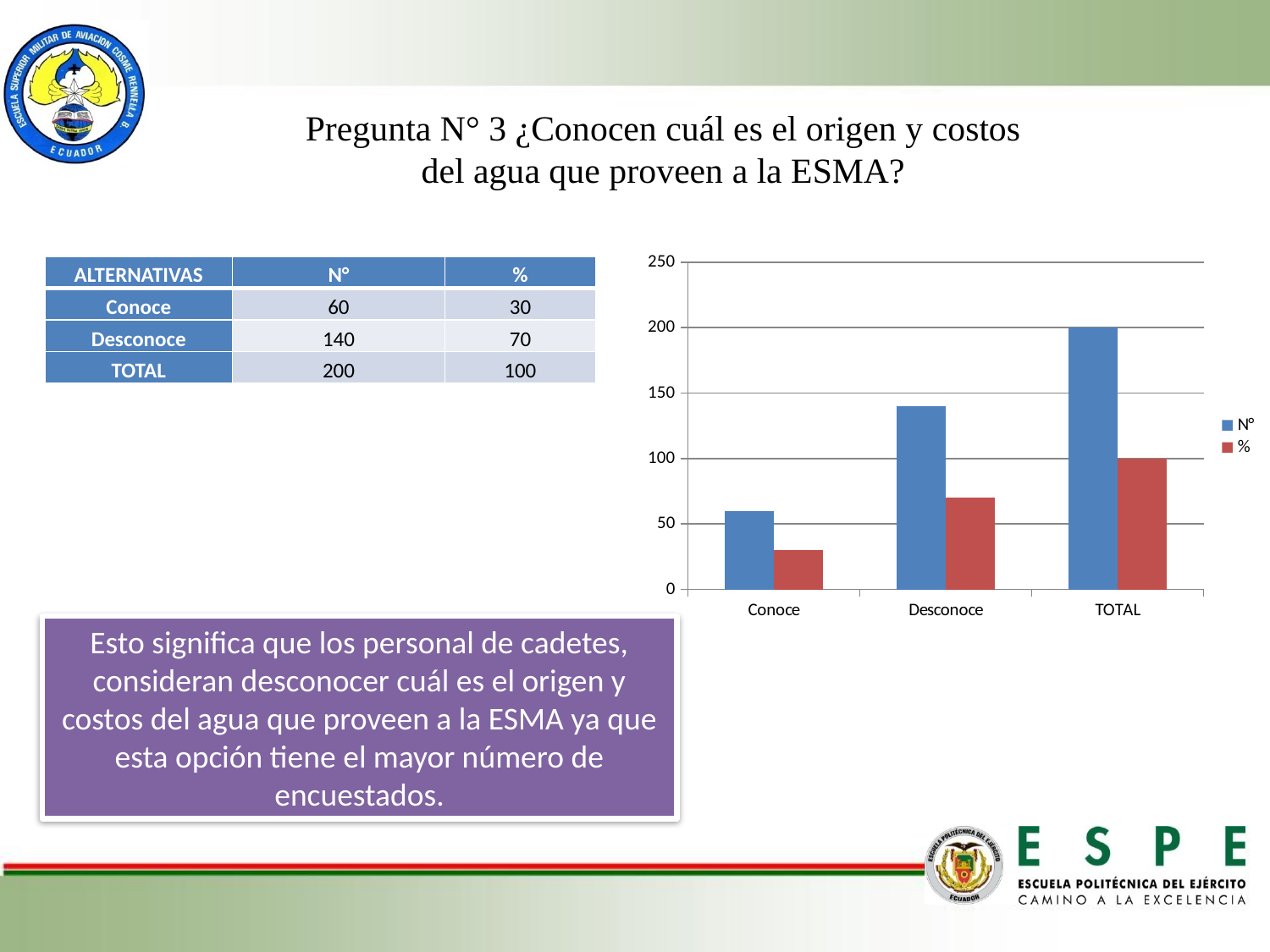
How many series does the chart legend list? 2 What type of chart is shown on the slide? bar chart Which is larger, the N° value for Desconoce or the N° value for Conoce? Desconoce What is the difference between the N° values for Desconoce and Conoce? 80 Is the % value for Desconoce greater or less than 100? less Is the N° value for Conoce greater or less than 50? greater What is the % value for TOTAL in the chart? 100 How many categories are shown on the x axis of the chart? 3 What is the N° value for TOTAL in the chart? 200 What is the N° value for Desconoce? 140 Which category has the lowest N° value? Conoce What is the % value for Conoce? 30